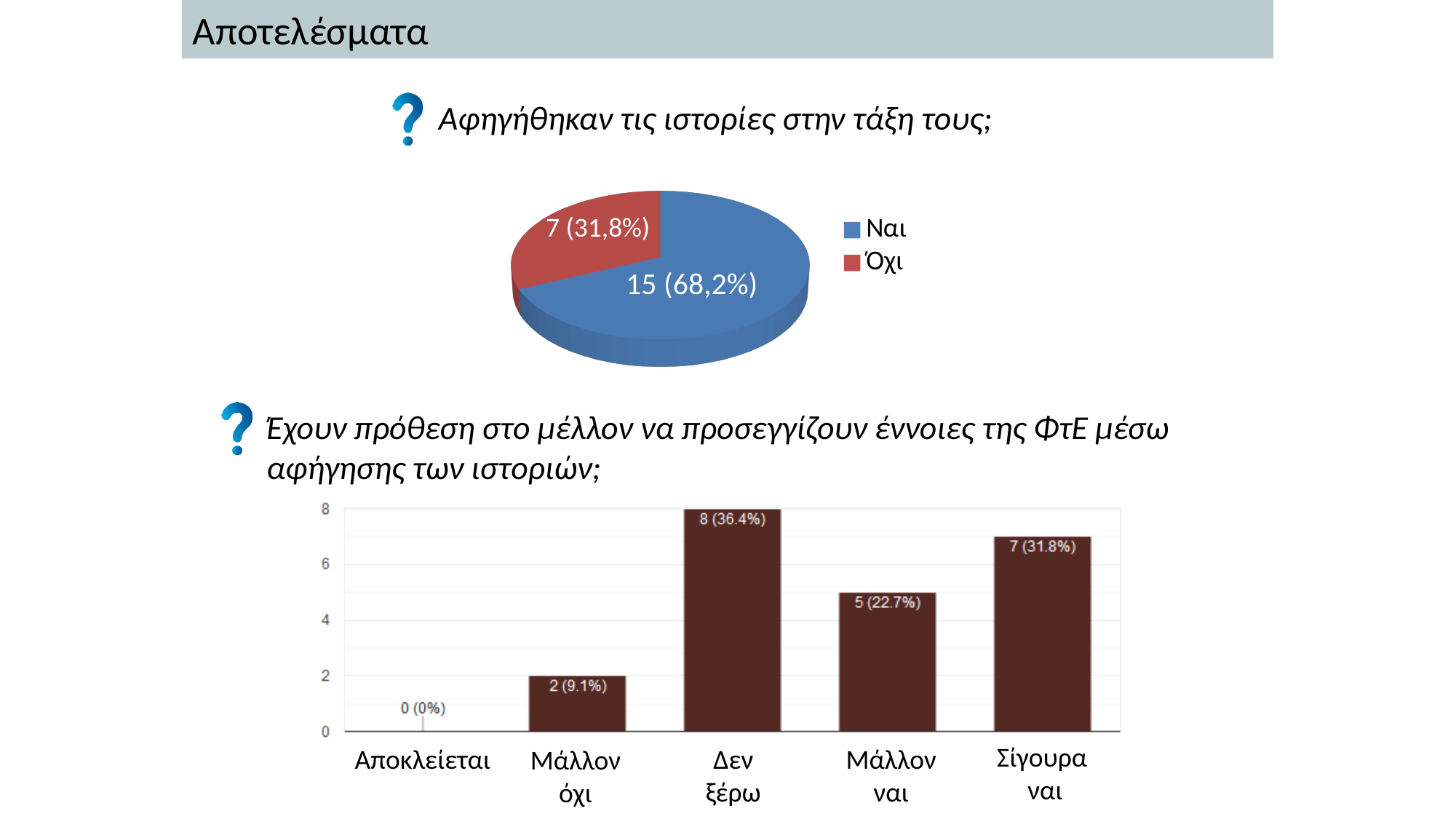
In the pie chart at the top of the slide, what share of the pie does the Όχι slice represent? 31,8% In the bar chart at the bottom of the slide, which category has the highest value? Δεν ξέρω In the pie chart at the top of the slide, how many entries does the legend list? 2 In the pie chart at the top of the slide, what is the data label for the Ναι slice? 15 (68,2%) In the bar chart at the bottom of the slide, how many categories are shown on the x axis? 5 In the pie chart at the top of the slide, what is the data label for the Όχι slice? 7 (31,8%) In the bar chart at the bottom of the slide, what is the data label for Δεν ξέρω? 8 (36.4%) In the bar chart at the bottom of the slide, what is the data label for Μάλλον ναι? 5 (22.7%) In the bar chart at the bottom of the slide, which category has the lowest value? Αποκλείεται What kind of chart is the chart at the bottom of the slide? Bar chart In the bar chart at the bottom of the slide, what is the difference between the counts for Σίγουρα ναι and Μάλλον όχι? 5 In the pie chart at the top of the slide, what colour is the Ναι slice? Blue